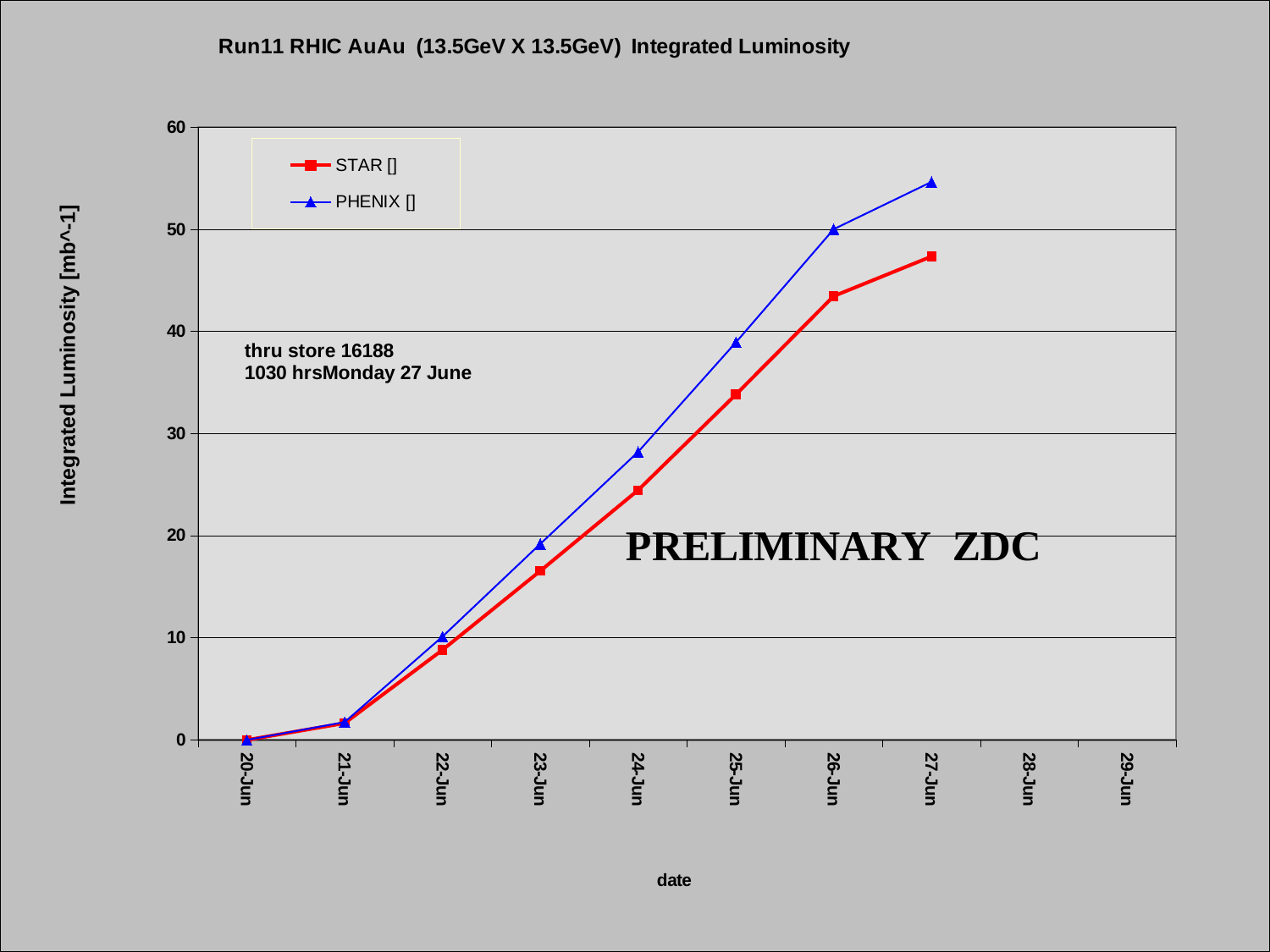
Is the STAR value on 25-Jun greater or less than 30? greater Is the PHENIX value on 27-Jun greater or less than 50? greater Which series are listed in the legend? STAR and PHENIX Is the STAR value on 27-Jun greater or less than 50? less On which date does the PHENIX series reach its highest value? 27-Jun Do the STAR values rise or fall from 20-Jun to 27-Jun? rise What kind of chart is shown on the slide? line chart How many series does the legend list? 2 On 27-Jun, which series has the larger value, STAR or PHENIX? PHENIX What is the label of the y axis? Integrated Luminosity [mb^-1] How many date labels are shown on the x axis? 10